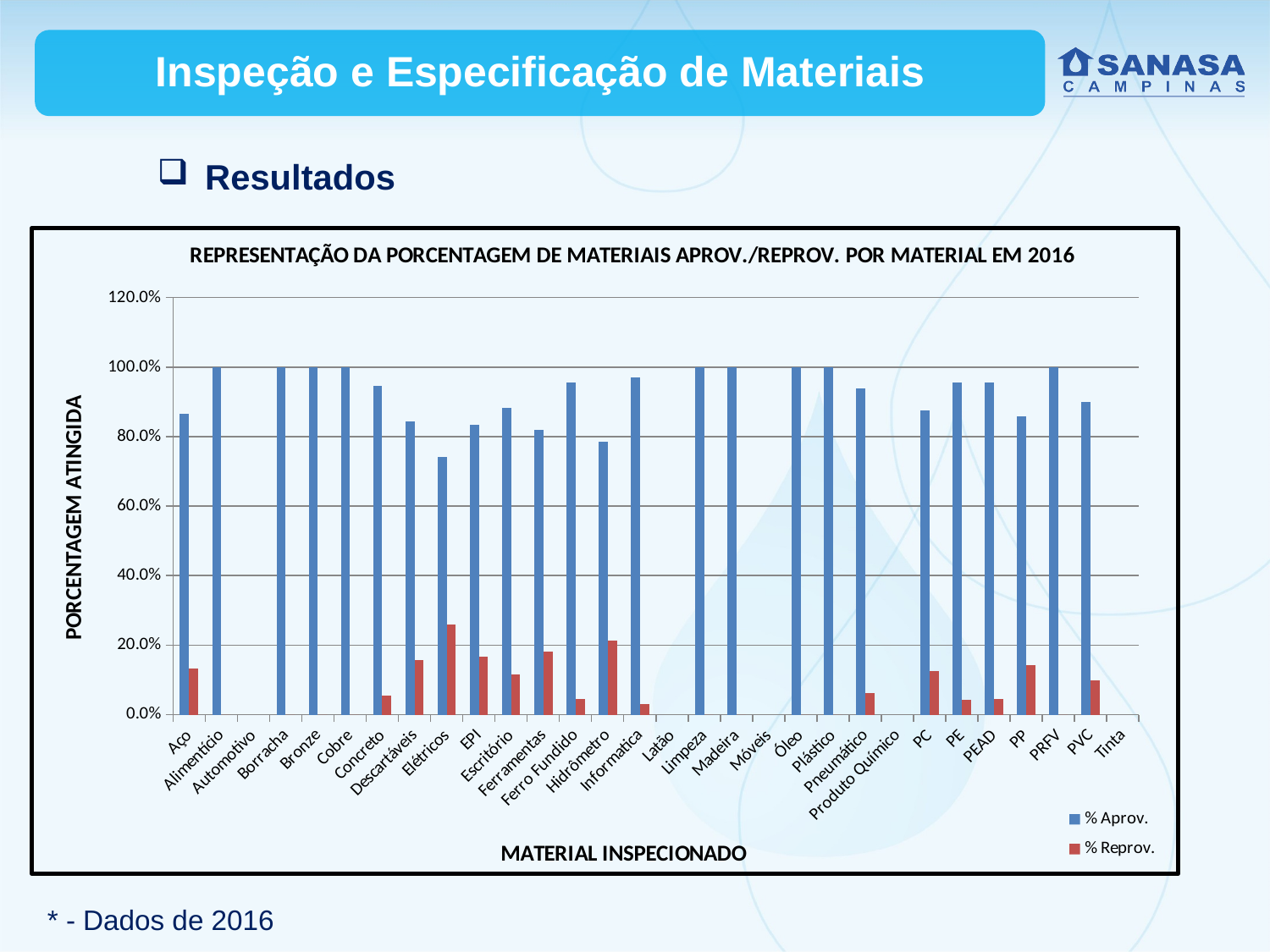
How many series does the legend list? 2 What kind of chart is shown on the slide? bar chart Is the % Aprov. value for Aço greater or less than 80.0%? greater Which is larger, the % Reprov. value for Hidrômetro or for Informática? Hidrômetro Is the % Reprov. value for Elétricos greater or less than 20.0%? greater How many material categories are shown on the x axis? 30 Which material has the highest % Reprov. value? Elétricos What is the label of the y axis? PORCENTAGEM ATINGIDA Is the % Aprov. value for Elétricos greater or less than 80.0%? less Which is larger, the % Aprov. value for Aço or for Elétricos? Aço What is the % Aprov. value for PRFV? 100.0% What is the % Aprov. value for Bronze? 100.0%